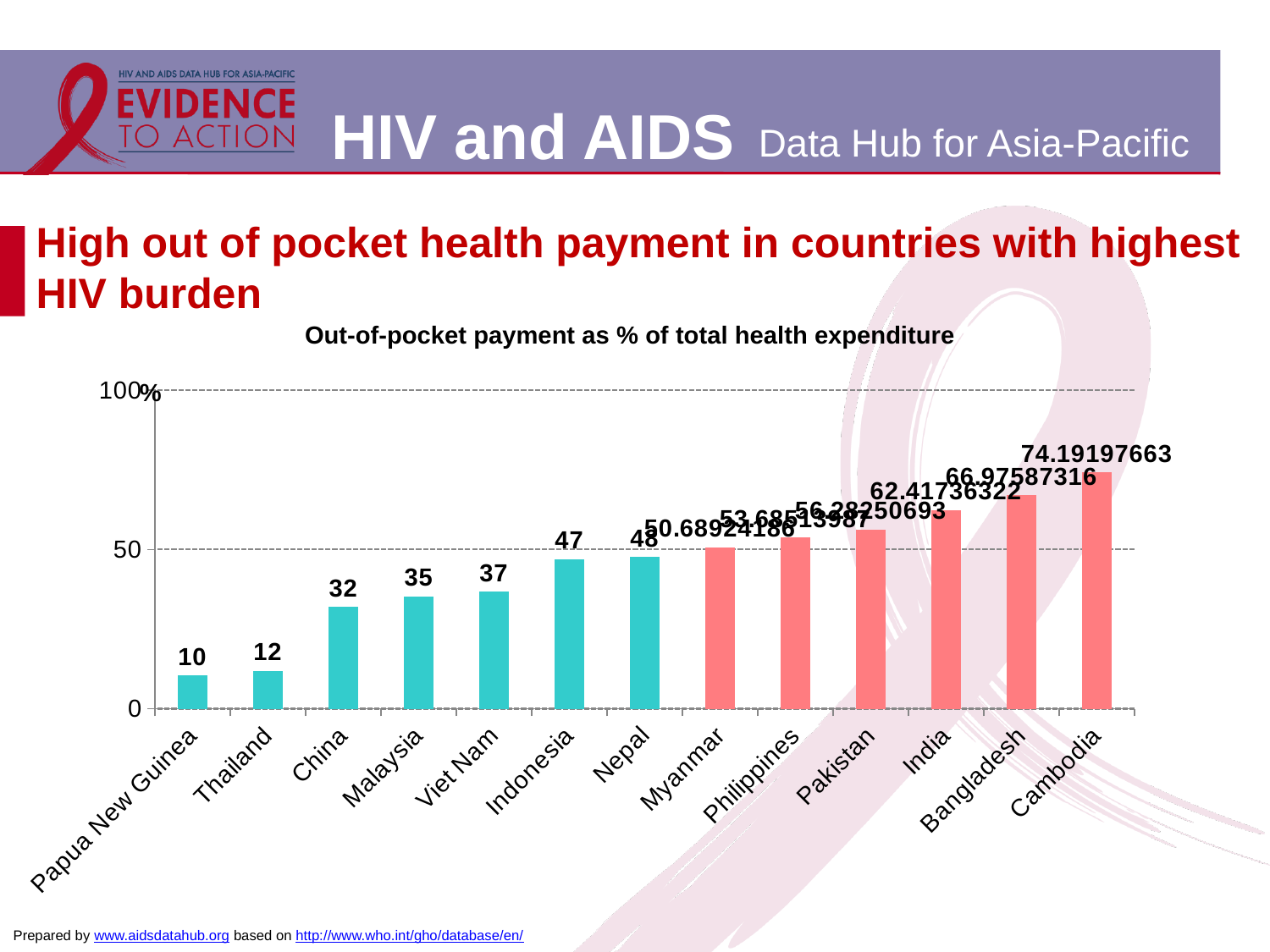
Do the values rise or fall from left to right across the countries? rise What is the out-of-pocket payment value shown for Papua New Guinea? 10 What kind of chart is shown on the slide? bar chart What is the difference between the values for Thailand and Papua New Guinea? 2 Which country has the lowest out-of-pocket payment share? Papua New Guinea Which has a larger value, Malaysia or Viet Nam? Viet Nam Is the value for Philippines greater or less than 50? greater How many countries are shown in the chart? 13 What value is shown for China? 32 Which country has the highest out-of-pocket payment share? Cambodia What value is shown for Cambodia? 74.19197663 What value is shown for India? 62.41736322